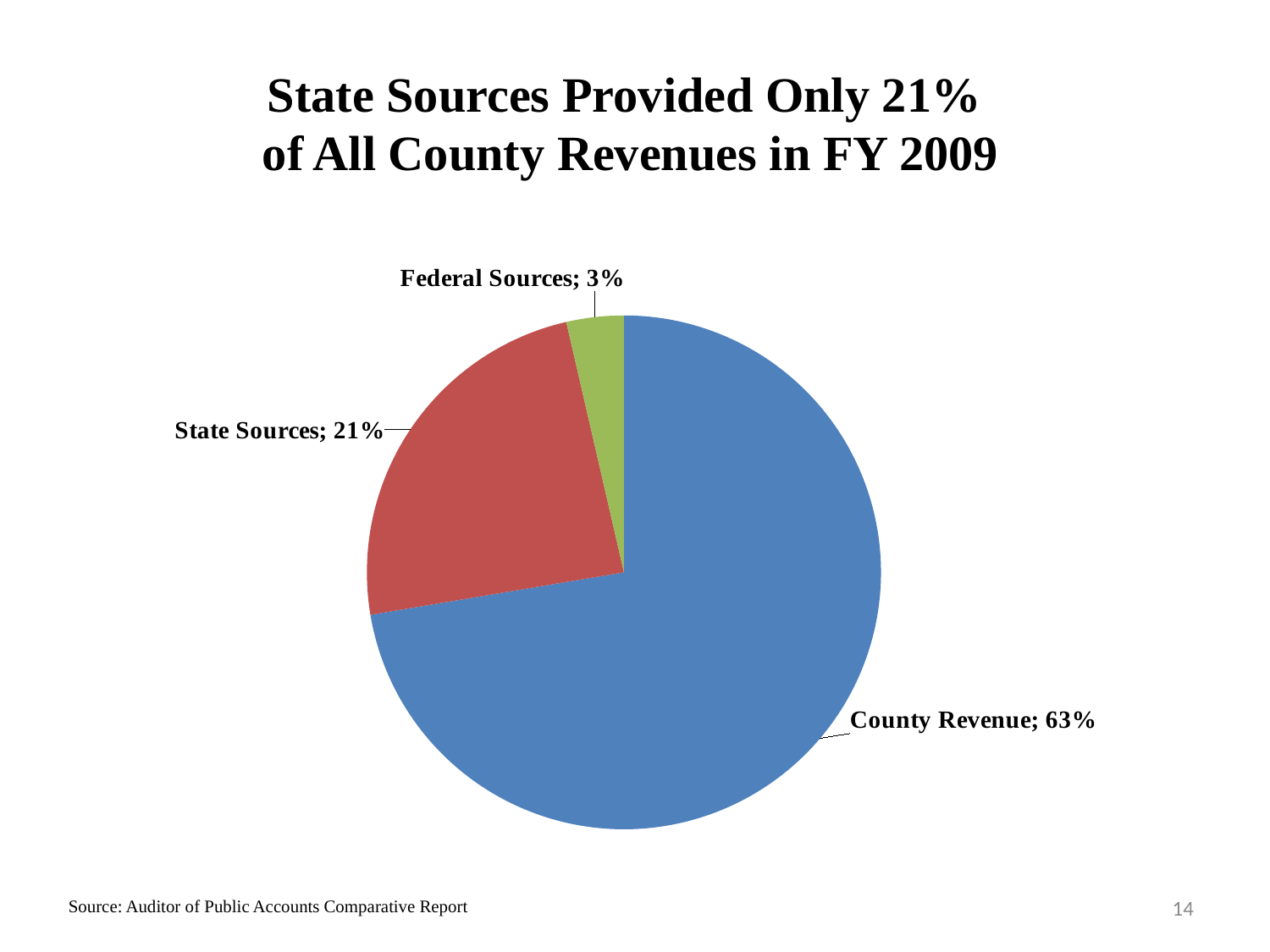
What share of county revenues came from State Sources? 21% What share of county revenues came from County Revenue? 63% What kind of chart is shown on the slide? Pie chart What is the title of the chart on the slide? State Sources Provided Only 21% of All County Revenues in FY 2009 Which revenue source has the largest slice of the pie? County Revenue What share of county revenues came from Federal Sources? 3% What is the difference in percentage points between County Revenue and State Sources? 42 Which is larger, the share for State Sources or the share for Federal Sources? State Sources How many slices does the pie chart have? 3 Which revenue source has the smallest slice of the pie? Federal Sources What colour is the County Revenue slice? Blue What is the difference in percentage points between State Sources and Federal Sources? 18